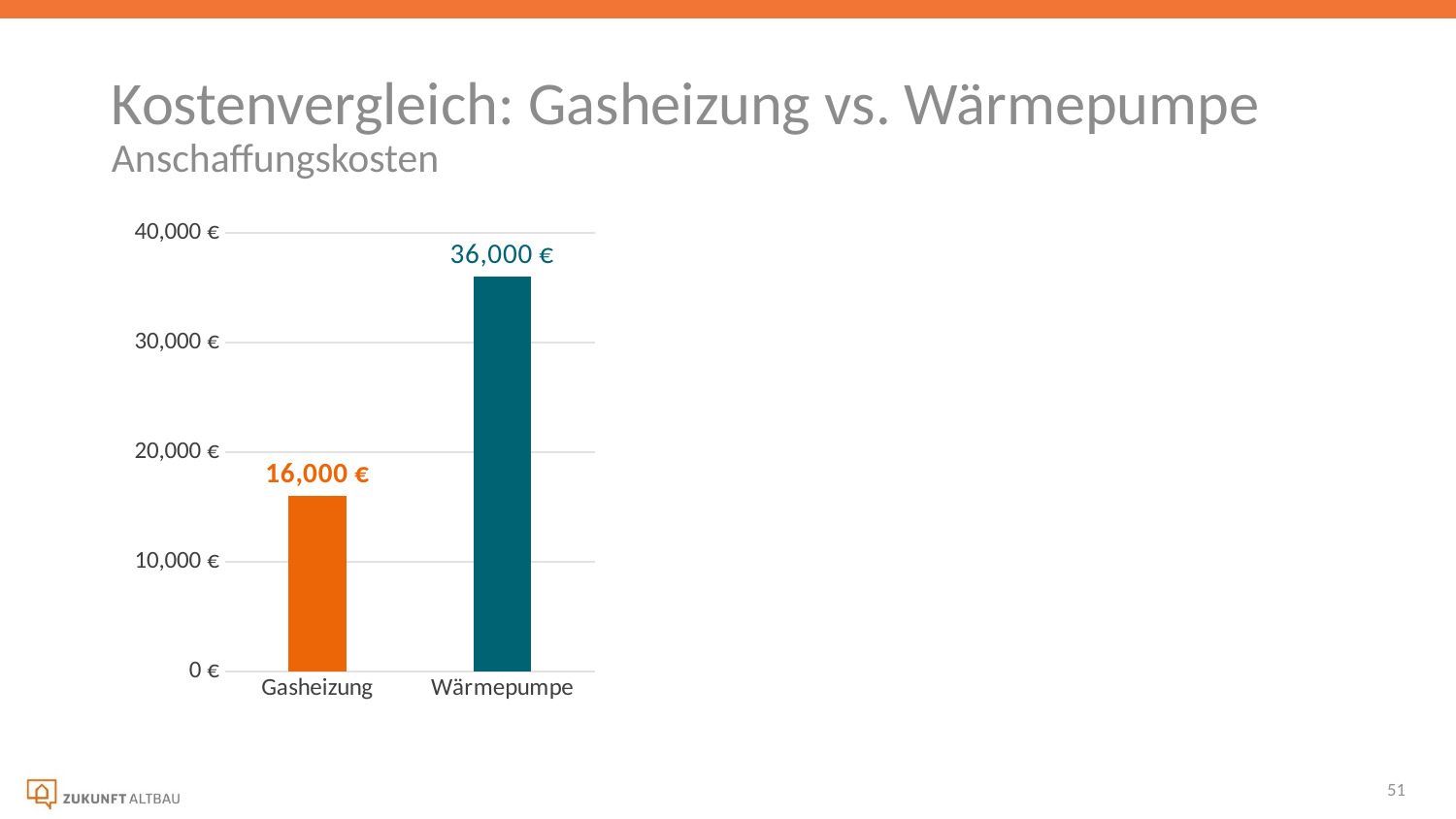
What kind of chart is shown on the slide? bar chart Which is larger, the value for Gasheizung or the value for Wärmepumpe? Wärmepumpe What colour is the bar for Gasheizung? orange Is the value for Gasheizung greater or less than 20,000 €? less What is the value for Wärmepumpe? 36,000 € What is the maximum value shown on the y axis? 40,000 € Which category has the lowest value? Gasheizung What is the difference between the values for Wärmepumpe and Gasheizung? 20,000 € What is the value for Gasheizung? 16,000 € How many categories are shown on the x axis? 2 Which category has the highest value? Wärmepumpe Is the value for Wärmepumpe greater or less than 30,000 €? greater